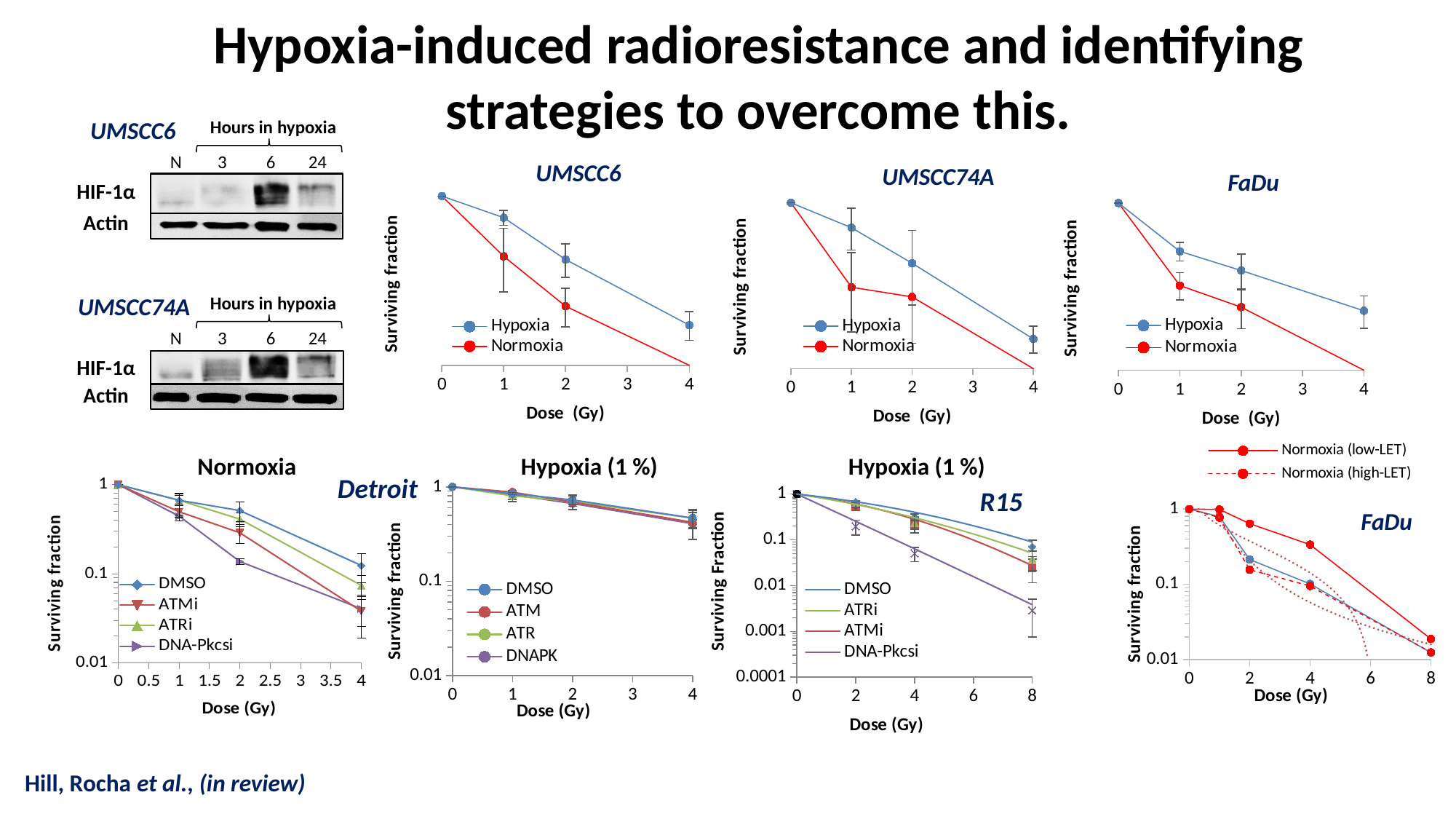
In the FaDu chart (top row), does the surviving fraction rise or fall as dose increases? Fall What kind of chart is the UMSCC74A chart in the top row? Line chart In the Normoxia (Detroit) chart in the bottom row, how many series does the legend list? 4 In the Hypoxia (1 %) R15 chart in the bottom row, which series has the highest surviving fraction at 8 Gy? DMSO In the UMSCC6 chart (top row), what are the two series named in the legend? Hypoxia and Normoxia In the UMSCC6 chart (top row), how many series does the legend list? 2 In the Hypoxia (1 %) R15 chart in the bottom row, which series has the lowest surviving fraction at 8 Gy? DNA-Pkcsi In the Hypoxia (1 %) Detroit chart in the bottom row, what is the maximum dose shown on the x axis? 4 In the FaDu chart in the bottom right, what are the two series named in the legend? Normoxia (low-LET) and Normoxia (high-LET) In the UMSCC6 chart (top row), which series has the higher surviving fraction at a dose of 2 Gy, Hypoxia or Normoxia? Hypoxia In the Normoxia (Detroit) chart in the bottom row, is the surviving fraction for DNA-Pkcsi at 4 Gy greater or less than 0.1? less In the Normoxia (Detroit) chart in the bottom row, is the surviving fraction for DMSO at 4 Gy greater or less than 0.1? greater